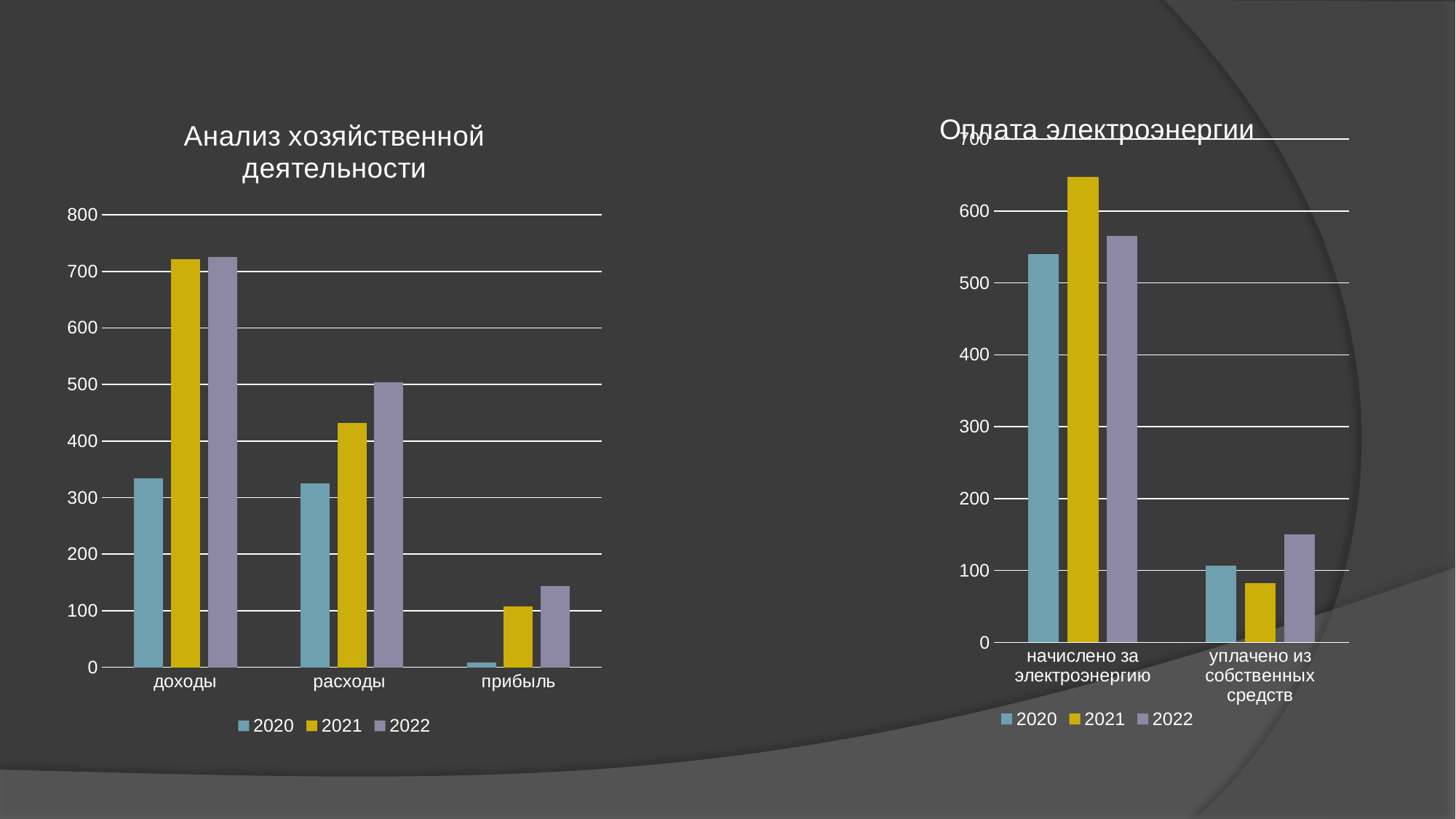
In the left chart "Анализ хозяйственной деятельности", is the 2022 value for расходы greater or less than 400? greater In the right chart "Оплата электроэнергии", how many categories are shown on the x axis? 2 In the left chart "Анализ хозяйственной деятельности", which year has the lowest value for прибыль? 2020 What is the title of the right chart? Оплата электроэнергии In the right chart "Оплата электроэнергии", which is larger for уплачено из собственных средств: the 2020 value or the 2021 value? 2020 In the left chart "Анализ хозяйственной деятельности", how many series does the legend list? 3 In the right chart "Оплата электроэнергии", is the 2022 value for уплачено из собственных средств greater or less than 100? greater What kind of chart is the left chart titled "Анализ хозяйственной деятельности"? bar chart In the left chart "Анализ хозяйственной деятельности", how many categories are shown on the x axis? 3 In the right chart "Оплата электроэнергии", which year has the highest value for начислено за электроэнергию? 2021 In the left chart "Анализ хозяйственной деятельности", is the 2020 value for доходы greater or less than 400? less In the left chart "Анализ хозяйственной деятельности", which is larger for прибыль: the 2021 value or the 2022 value? 2022